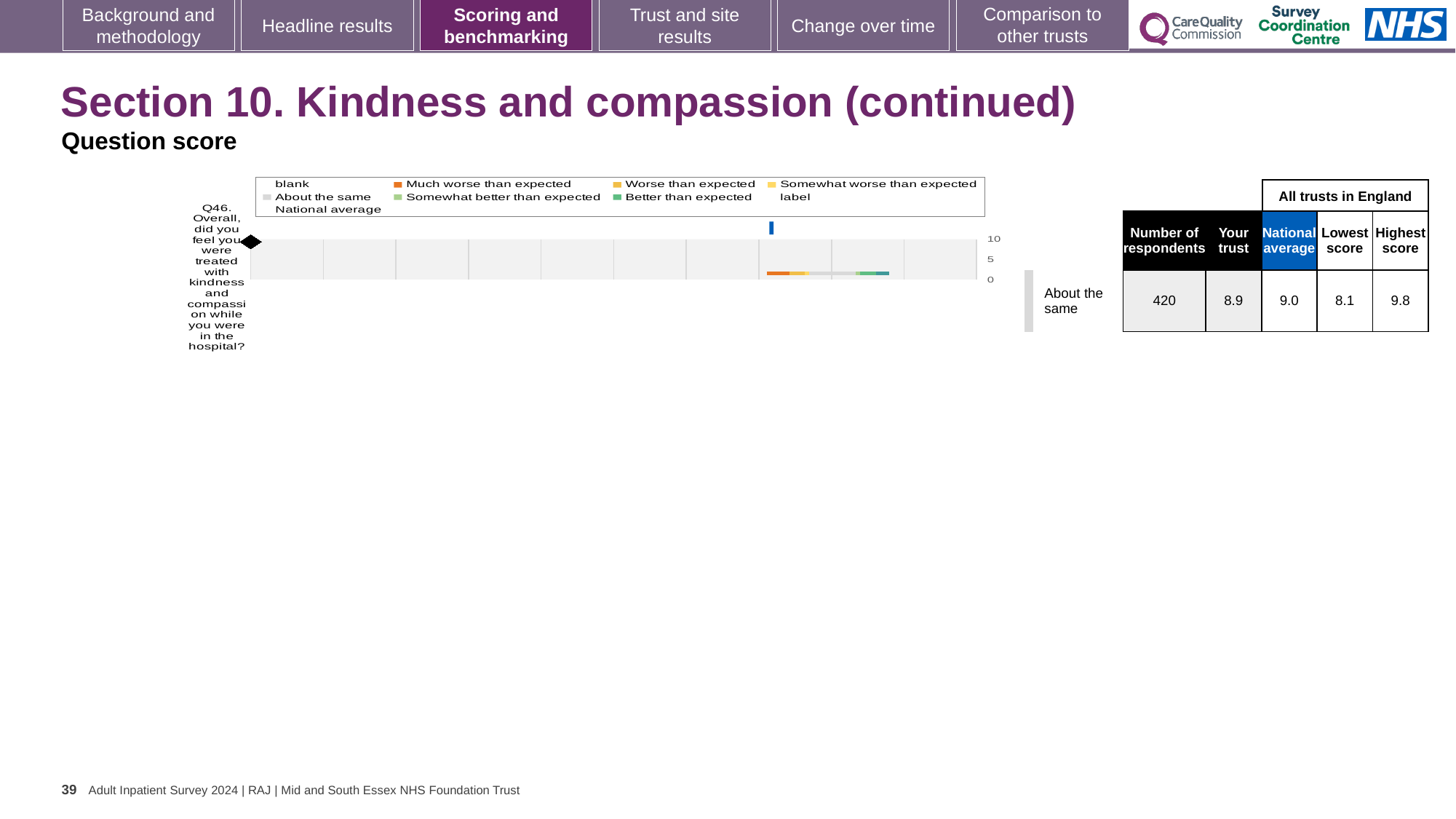
What kind of chart is shown on the slide for Q46? bar chart What is the national average score for Q46? 9.0 Which is larger for Q46: the trust's score or the national average? National average What is the highest score among all trusts in England for Q46? 9.8 What is the highest value shown on the chart's numeric axis? 10 What is the lowest score among all trusts in England for Q46? 8.1 Which benchmarking category is Q46 assigned to on the slide? About the same What is the difference between the highest score and the lowest score for Q46? 1.7 What is the 'Your trust' score for Q46? 8.9 Is the trust's score for Q46 greater or less than 5 on the chart's axis? greater How many respondents answered Q46? 420 How many questions (categories) are plotted on the chart? 1